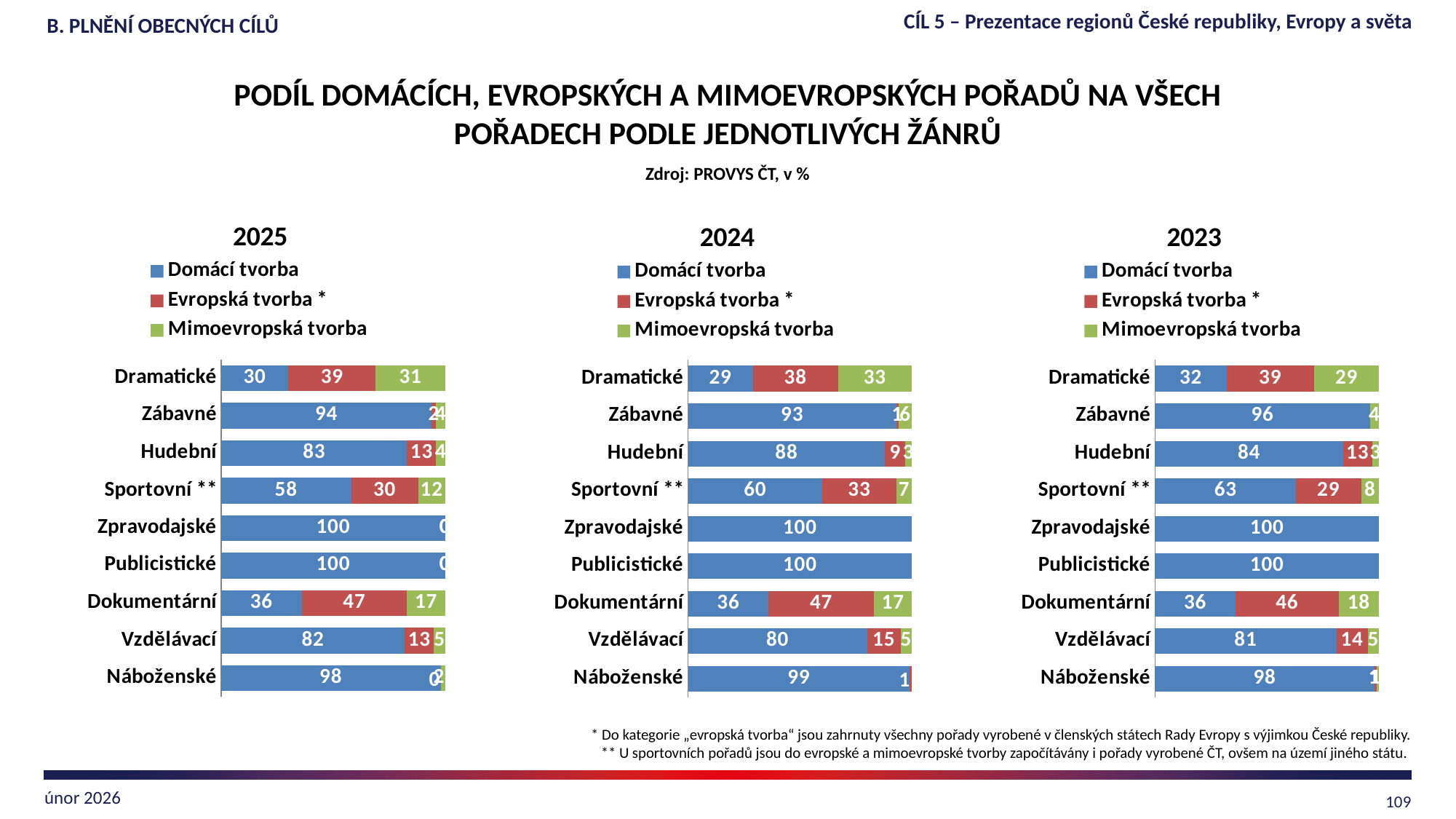
What type of chart is used for the 2025 data? stacked bar chart In the 2025 chart, what is the value of Domácí tvorba for Dramatické? 30 In the 2024 chart, what is the total of the stacked bar for Dramatické? 100 In the 2025 chart, is the Domácí tvorba value for Hudební larger or smaller than the Domácí tvorba value for Vzdělávací? larger In the 2025 chart, which category has the lowest Domácí tvorba value? Dramatické In the 2023 chart, what is the difference between the Domácí tvorba values for Sportovní and Dramatické? 31 Which series is shown in green in the legends of the three charts? Mimoevropská tvorba In the 2024 chart, what is the value of Evropská tvorba for Sportovní? 33 How many categories are shown in the 2024 chart? 9 How many series does the legend of the 2023 chart list? 3 In the 2023 chart, what is the value of Mimoevropská tvorba for Dokumentární? 18 In the 2024 chart, which category has the highest Evropská tvorba value? Dokumentární